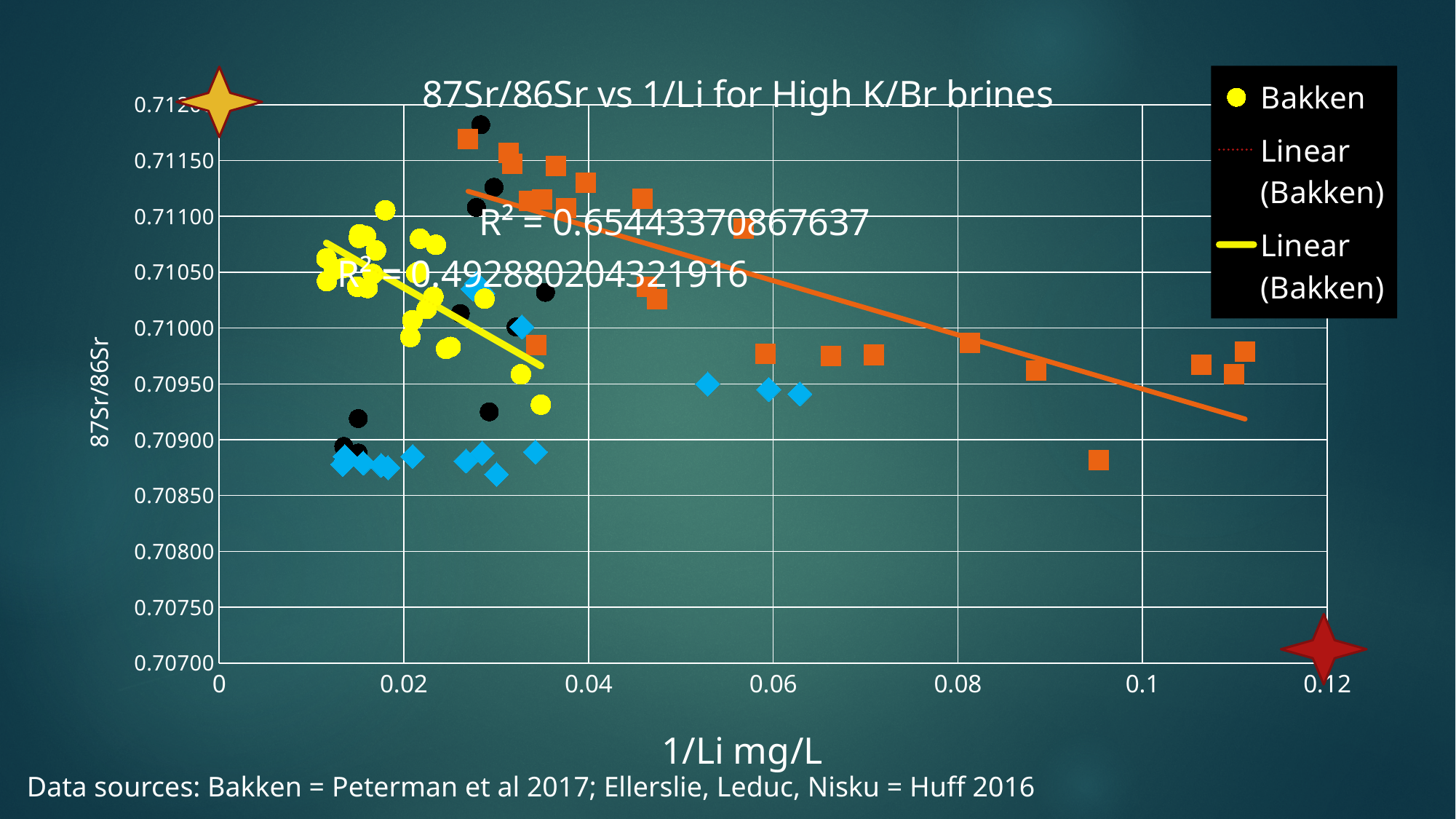
What is the label on the y axis of the chart? 87Sr/86Sr Is the 87Sr/86Sr value of the highest orange square (near 1/Li = 0.027) greater or less than 0.71150? greater How many entries does the chart legend list? 3 What is the smaller of the two R² values printed on the chart? 0.492880204321916 Is the 87Sr/86Sr value of the orange square near 1/Li = 0.095 greater or less than 0.70900? less Which has the higher 87Sr/86Sr value: the orange square near 1/Li = 0.095 or the orange square near 1/Li = 0.111? the orange square near 1/Li = 0.111 Are the 87Sr/86Sr values of the blue diamonds near 1/Li = 0.015 greater or less than 0.70900? less What is the title of the chart? 87Sr/86Sr vs 1/Li for High K/Br brines Do the fitted trendlines rise or fall as 1/Li increases along the x axis? fall What kind of chart is shown on the slide? scatter chart What is the larger of the two R² values printed on the chart? 0.65443370867637